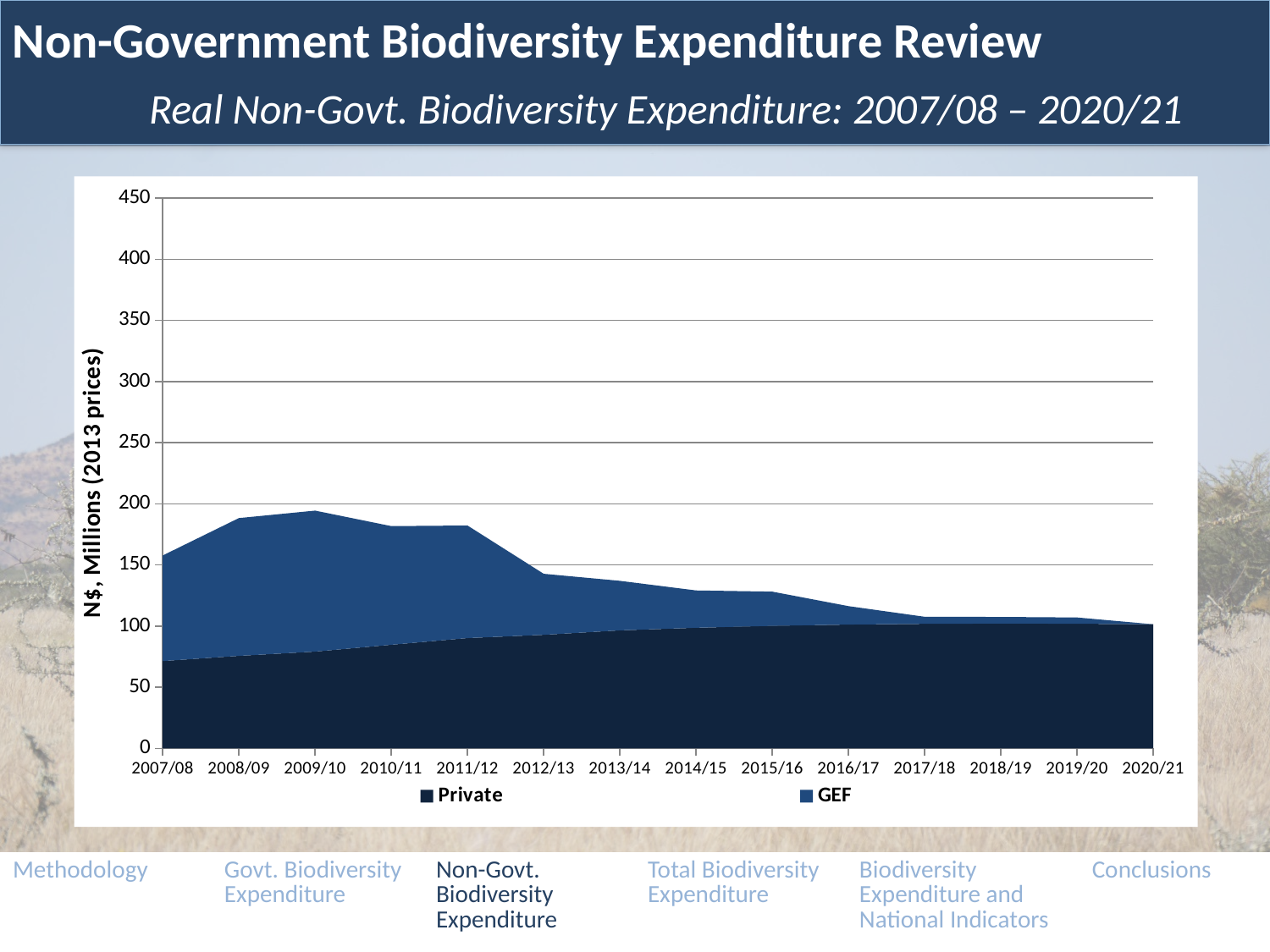
Is the total non-government expenditure (Private plus GEF) for 2015/16 greater or less than 100? greater How many series does the legend list? 2 Is the total non-government expenditure (Private plus GEF) for 2008/09 greater or less than 150? greater Is the total non-government expenditure (Private plus GEF) for 2009/10 greater or less than 150? greater What is the label on the vertical axis? N$, Millions (2013 prices) Does the Private series rise or fall from 2007/08 to 2017/18? rise What are the two series named in the legend? Private and GEF Does the total non-government expenditure rise or fall from 2009/10 to 2020/21? fall How many fiscal years are plotted along the x axis? 14 What kind of chart is shown on the slide? Stacked area chart Which year has the larger total non-government expenditure, 2007/08 or 2012/13? 2007/08